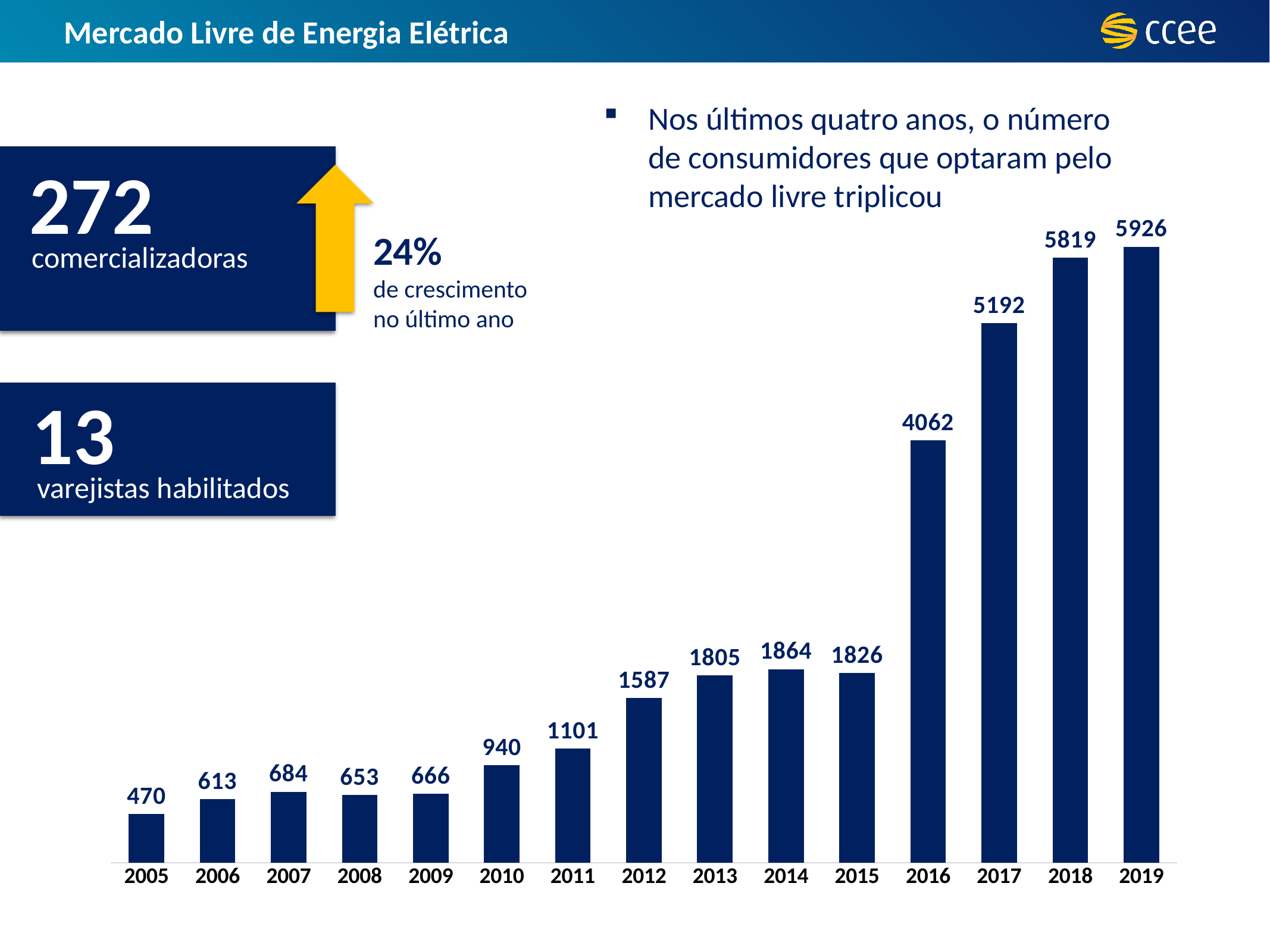
What kind of chart is shown on the slide? bar chart Which is larger, the value for 2014 or the value for 2015? 2014 Which year has the highest value? 2019 Which is larger, the value for 2007 or the value for 2008? 2007 Which year has the lowest value? 2005 What is the value shown for 2012? 1587 What is the value shown for 2005? 470 What is the value shown for 2016? 4062 How many years are shown on the x axis? 15 What is the difference between the values for 2016 and 2015? 2236 Do the values generally rise or fall from 2005 to 2019? rise What is the difference between the values for 2019 and 2018? 107